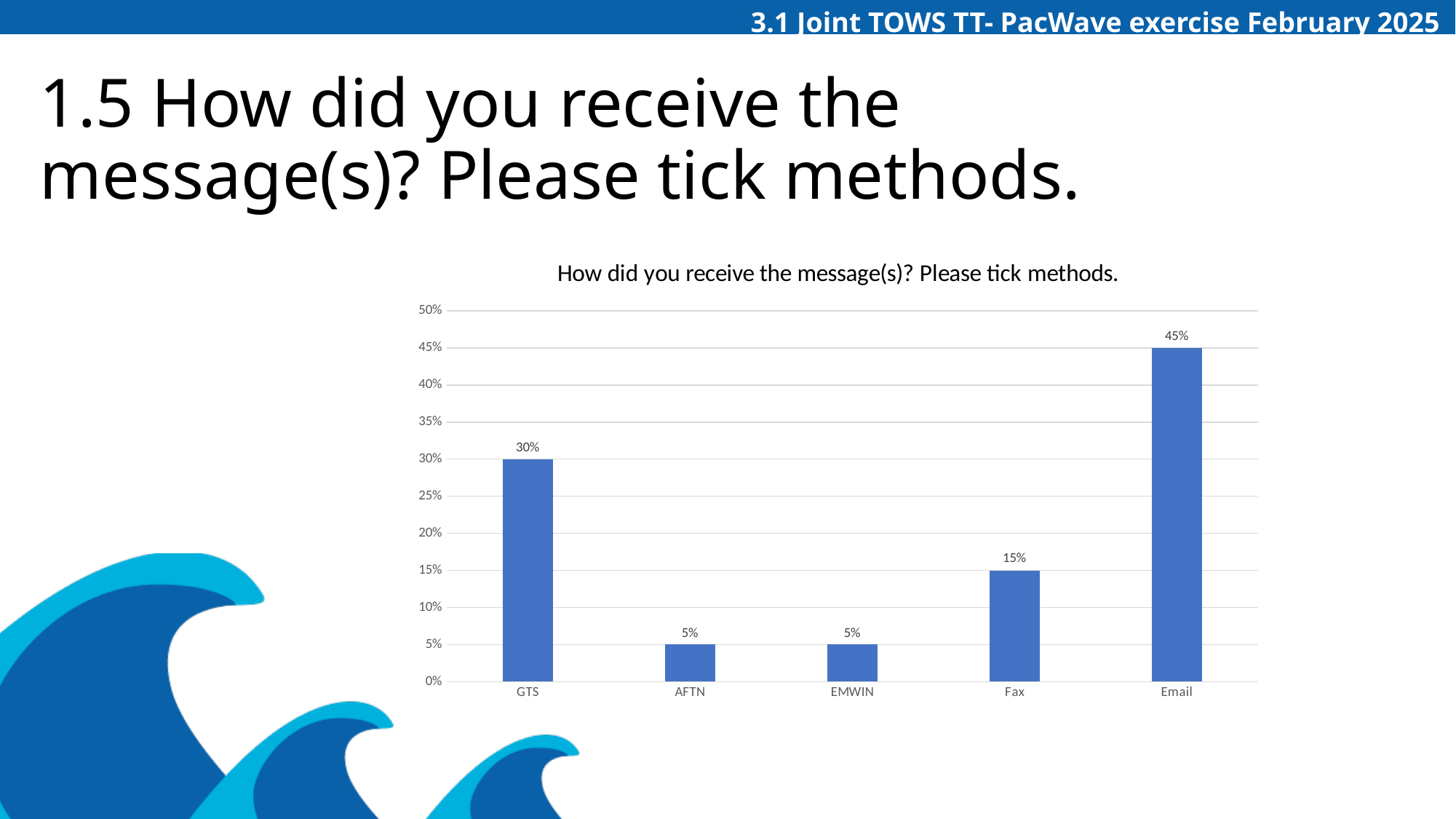
What is the difference between the values for GTS and Fax? 15% Which is larger, the value for Fax or the value for EMWIN? Fax What is the value for AFTN? 5% How many categories are shown on the x axis? 5 Is the value for Email greater or less than 40%? greater What is the difference between the values for Email and GTS? 15% What is the value for Email? 45% What is the title of the chart? How did you receive the message(s)? Please tick methods. What kind of chart is shown on the slide? bar chart What is the value for Fax? 15% Which category has the highest value? Email What is the value for GTS? 30%